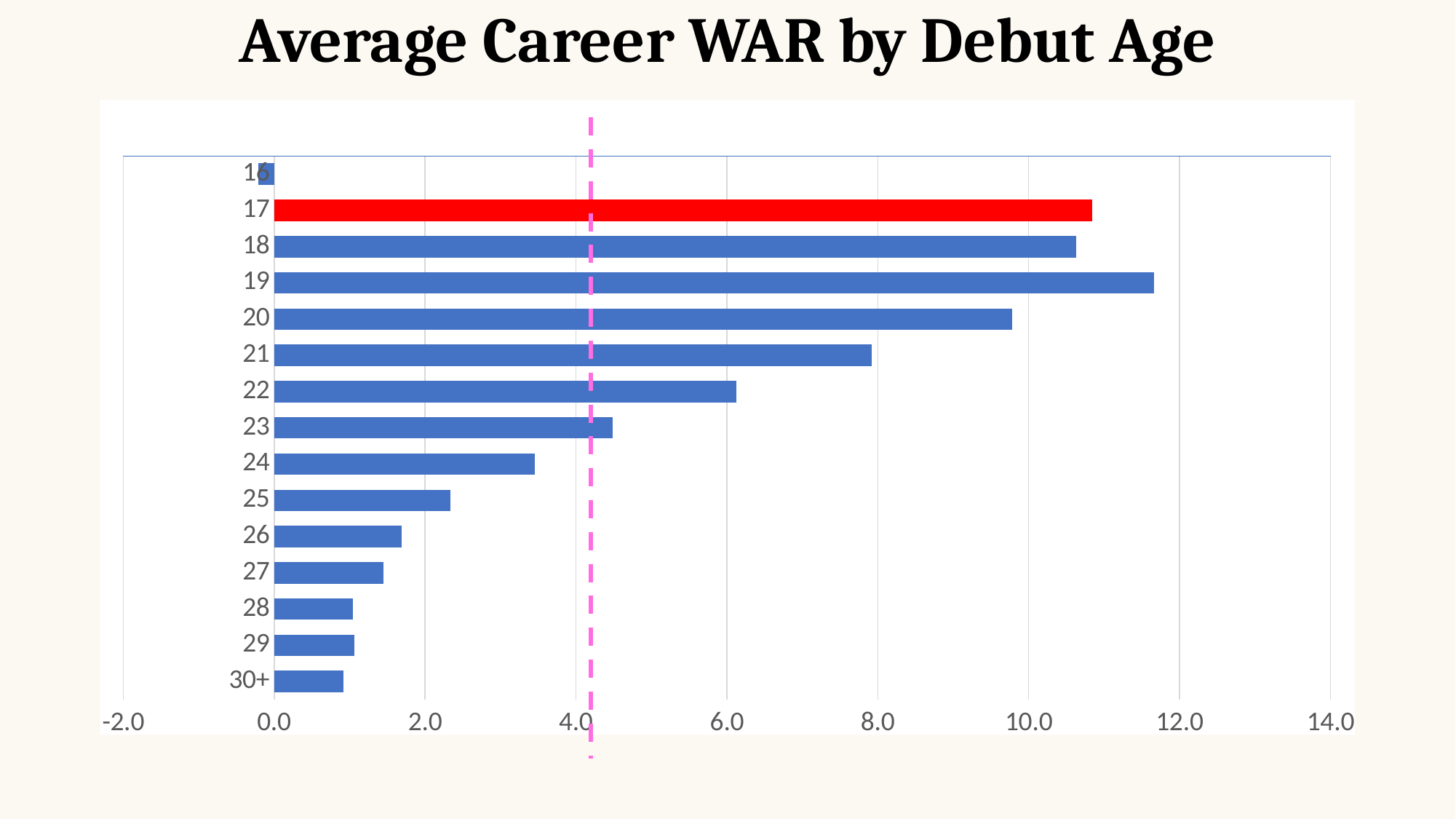
From debut age 19 down to 30+, do the bars generally get longer or shorter? Shorter Is the value for debut age 18 greater or less than 10.0? greater Is the value for debut age 27 greater or less than 2.0? less Which has the larger average career WAR, debut age 21 or debut age 22? 21 Which has the larger average career WAR, debut age 25 or debut age 26? 25 How many debut-age categories are plotted on the chart? 15 Which debut age has the highest average career WAR? 19 Which debut age's bar is coloured red? 17 Is the value for debut age 24 greater or less than 4.0? less What kind of chart is shown on the slide? Bar chart Which debut age has the lowest average career WAR? 16